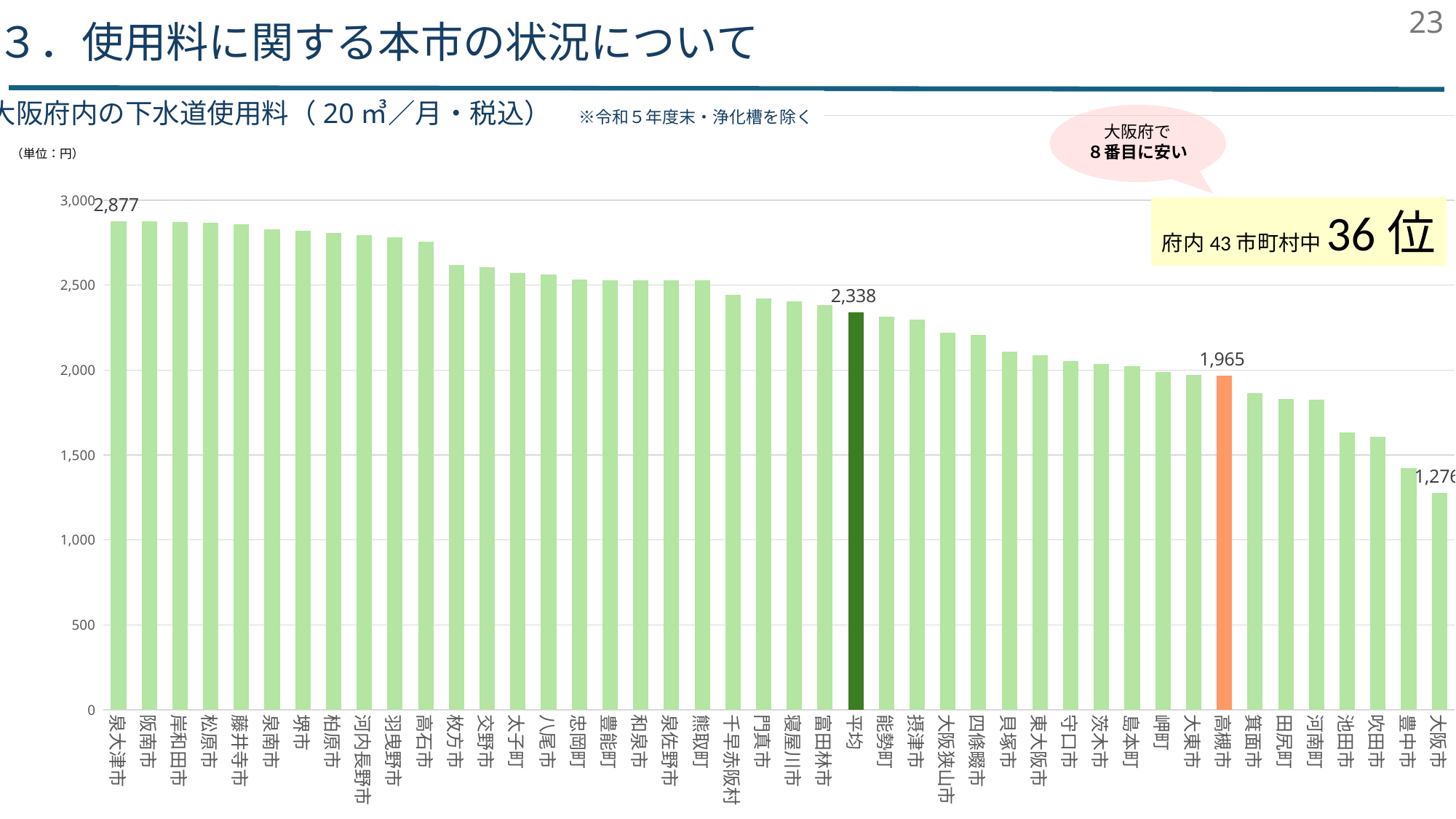
Do the values rise or fall from left to right along the x axis? fall Is the value for 堺市 greater or less than 2,500? greater Which category has the highest value? 泉大津市 What is the value for 大阪市? 1,276 What is the difference between the value for 平均 and the value for 高槻市? 373 Which is larger, the value for 高槻市 or the value for 平均? 平均 What is the value for 高槻市? 1,965 How many bars are plotted in the chart? 44 What is the value for 平均? 2,338 Which category has the lowest value? 大阪市 Is the value for 箕面市 greater or less than 2,000? less What is the value for 泉大津市? 2,877